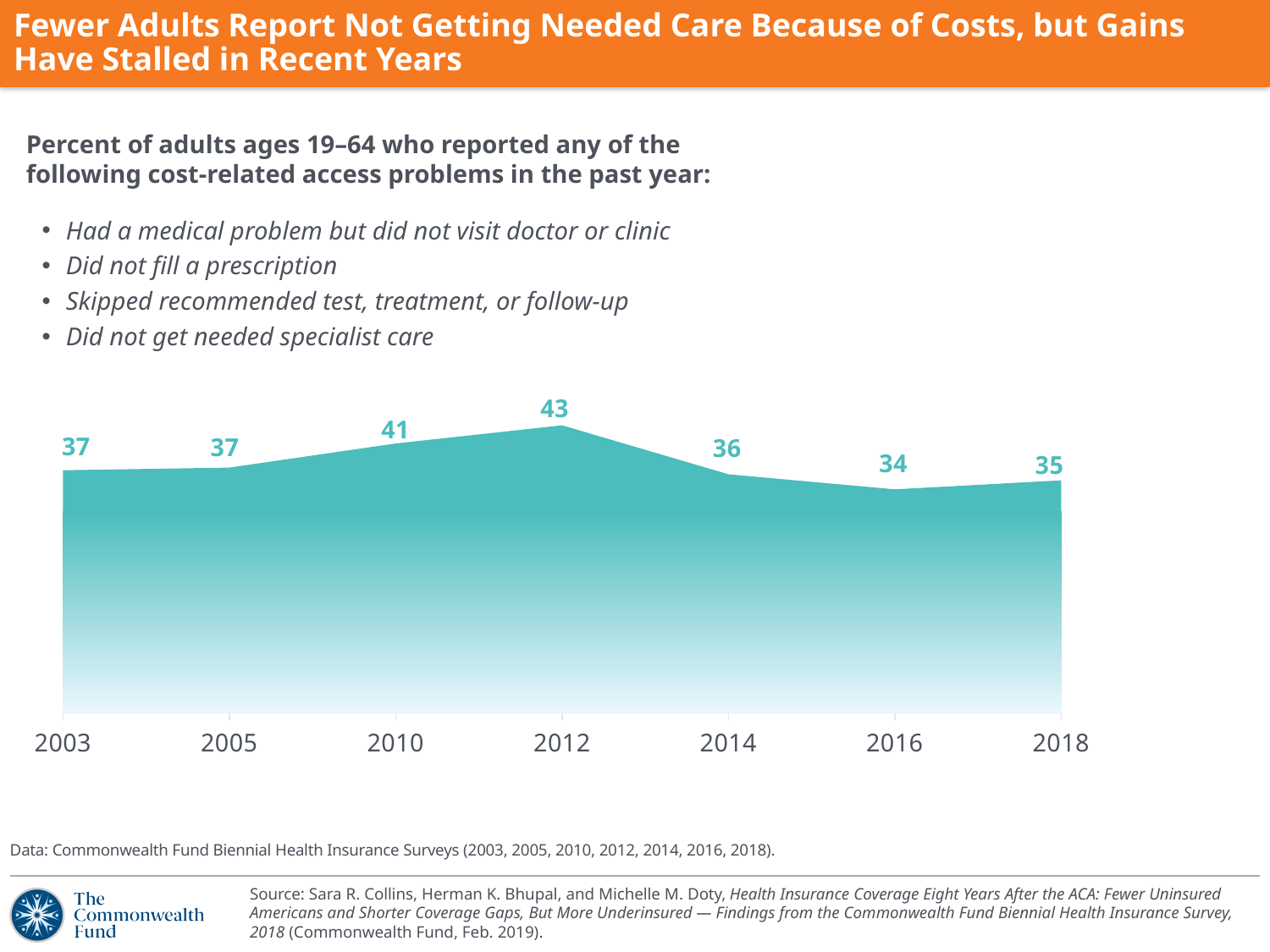
What is the difference between the 2012 value and the 2018 value? 8 Which year has the lowest value? 2016 How many years are plotted on the chart? 7 What is the value shown for 2003? 37 What kind of chart is shown? Area chart What is the difference between the 2010 value and the 2014 value? 5 Do the values rise or fall from 2012 to 2016? Fall Which is larger, the value for 2010 or the value for 2016? 2010 Which year has the highest value? 2012 What percent of adults reported a cost-related access problem in 2012? 43 Do the values rise or fall from 2003 to 2012? Rise What is the value shown for 2018? 35